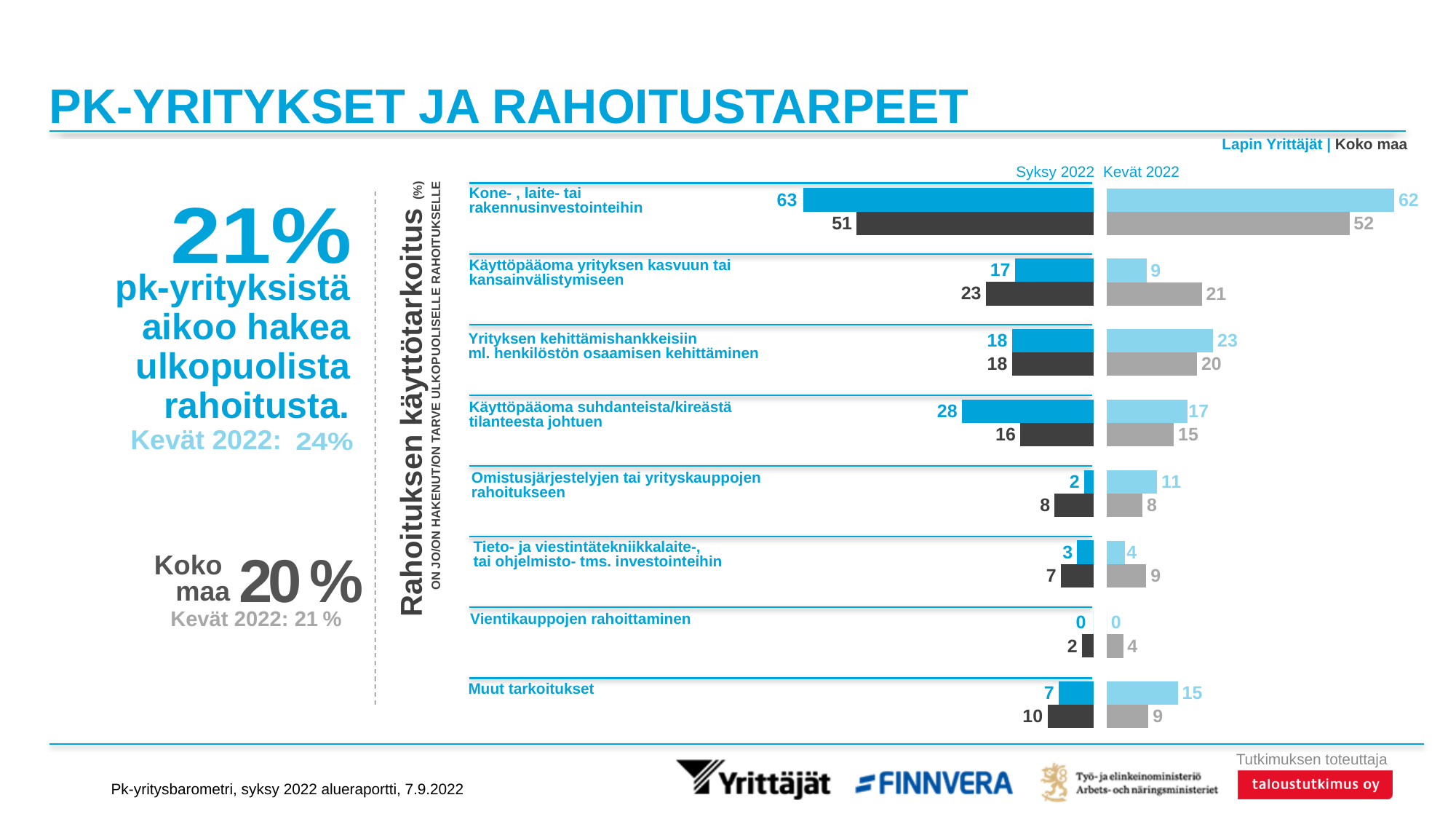
For "Käyttöpääoma yrityksen kasvuun tai kansainvälistymiseen", which is larger in Syksy 2022: the Lapin Yrittäjät value or the Koko maa value? Koko maa What is the difference between the Kevät 2022 Lapin Yrittäjät value and the Kevät 2022 Koko maa value for "Käyttöpääoma yrityksen kasvuun tai kansainvälistymiseen"? 12 Which category has the highest Syksy 2022 value for Lapin Yrittäjät? Kone-, laite- tai rakennusinvestointeihin What is the Syksy 2022 value for Koko maa for "Käyttöpääoma suhdanteista/kireästä tilanteesta johtuen"? 16 What is the Kevät 2022 value for Lapin Yrittäjät for "Omistusjärjestelyjen tai yrityskauppojen rahoitukseen"? 11 Which two survey periods are shown as column headings above the chart? Syksy 2022 and Kevät 2022 What is the Kevät 2022 value for Koko maa for "Muut tarkoitukset"? 9 Which category has the lowest Syksy 2022 value for Lapin Yrittäjät? Vientikauppojen rahoittaminen What is the difference between the Syksy 2022 Lapin Yrittäjät value and the Syksy 2022 Koko maa value for "Kone-, laite- tai rakennusinvestointeihin"? 12 What kind of chart is shown on the slide? Bar chart How many categories (financing purposes) are shown in the chart? 8 What is the Syksy 2022 value for Lapin Yrittäjät for "Kone-, laite- tai rakennusinvestointeihin"? 63